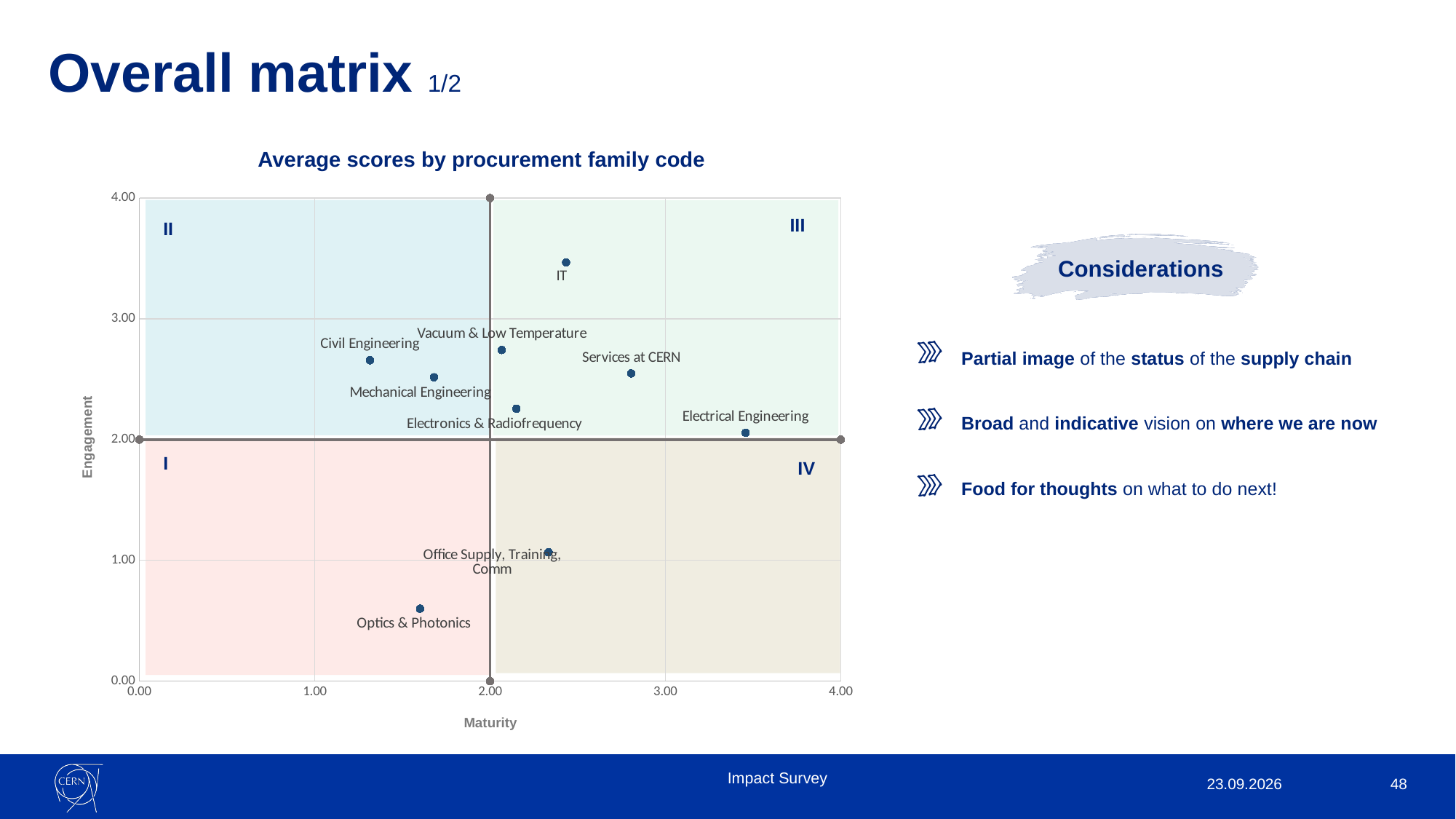
What is the title of the chart? Average scores by procurement family code Which procurement family has the highest Engagement score? IT Which has the higher Engagement score, IT or Services at CERN? IT Which procurement family has the lowest Engagement score? Optics & Photonics Is the Maturity value for Electrical Engineering greater or less than 3.00? greater Is the Engagement value for Optics & Photonics greater or less than 1.00? less Which procurement family has the lowest Maturity score? Civil Engineering Is the Maturity value for Civil Engineering greater or less than 2.00? less How many procurement family codes are plotted on the chart? 9 Which procurement family has the highest Maturity score? Electrical Engineering What kind of chart is shown on the slide? Scatter chart